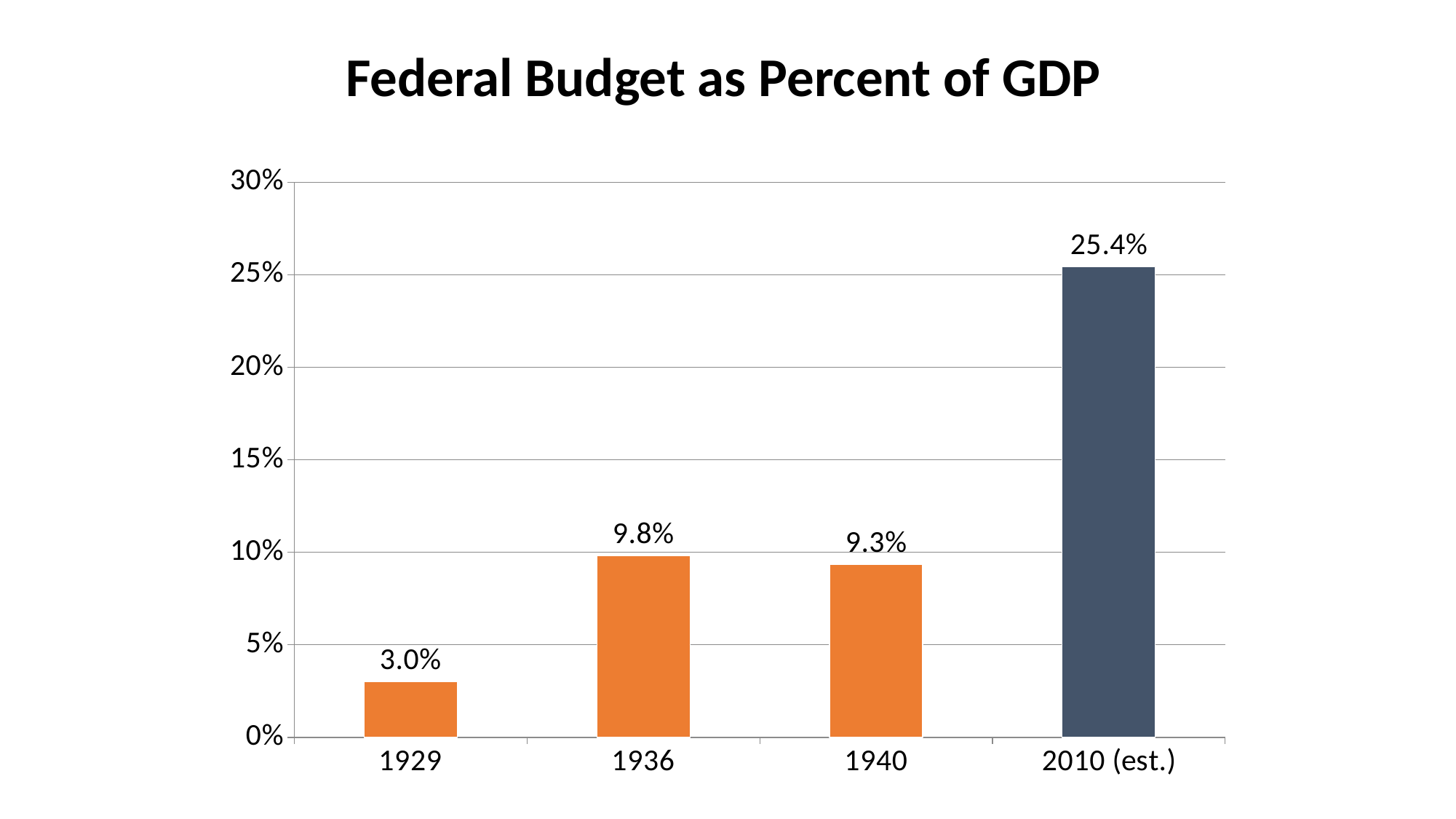
Which year has the lowest federal budget as percent of GDP? 1929 What is the federal budget as percent of GDP for 1940? 9.3% Is the value for 2010 (est.) greater or less than 25%? greater What is the federal budget as percent of GDP for 2010 (est.)? 25.4% What is the difference between the 2010 (est.) value and the 1940 value? 16.1% Which is larger, the value for 1936 or the value for 1940? 1936 How many years are shown on the chart? 4 What kind of chart is shown on the slide? Bar chart What is the federal budget as percent of GDP for 1936? 9.8% Which year has the highest federal budget as percent of GDP? 2010 (est.) What is the difference between the 1936 value and the 1929 value? 6.8% What is the federal budget as percent of GDP for 1929? 3.0%